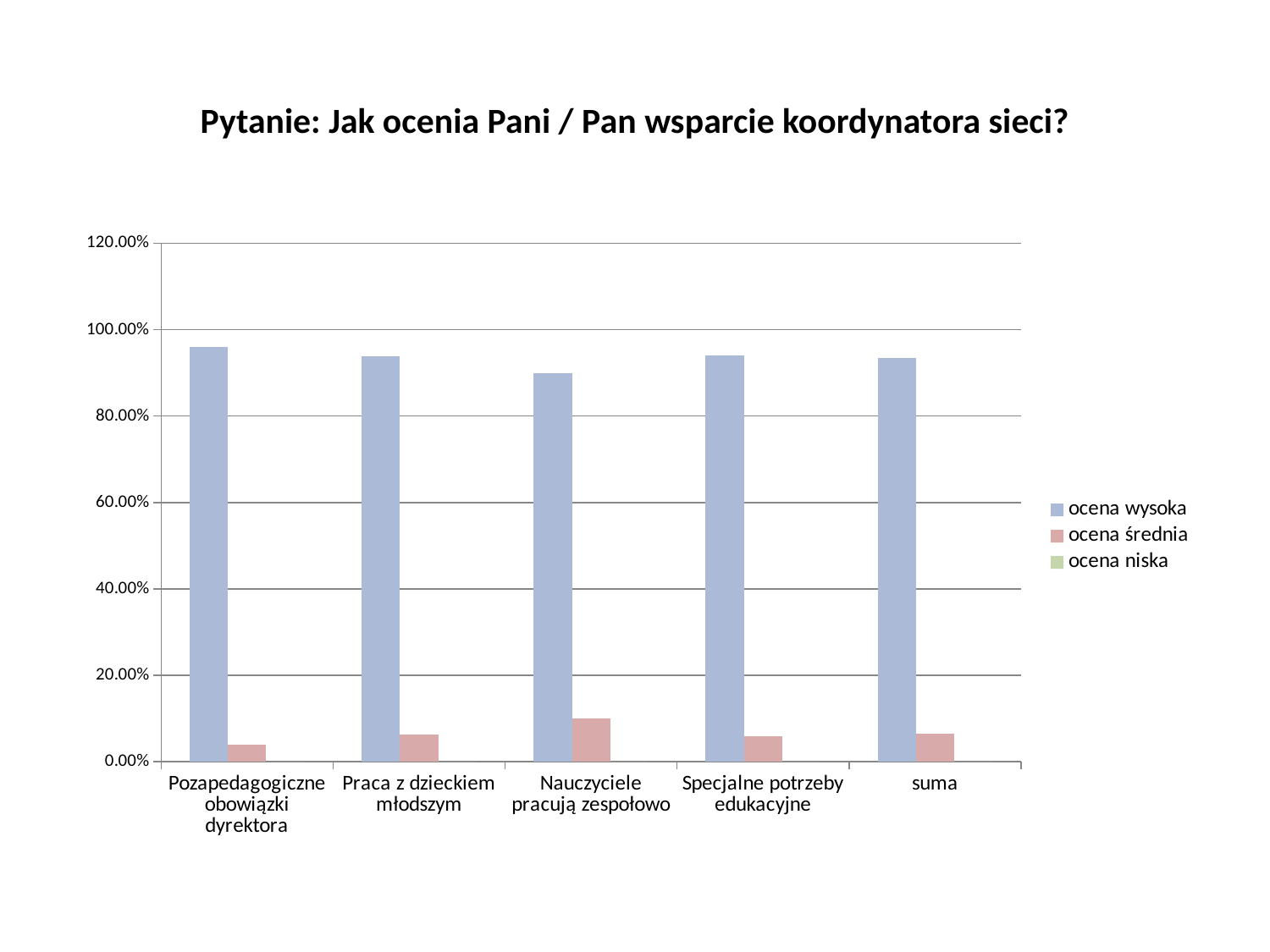
For the 'suma' category, which series has the larger value: 'ocena wysoka' or 'ocena średnia'? ocena wysoka How many categories are shown along the x axis? 5 Which category has the lowest value for the 'ocena średnia' series? Pozapedagogiczne obowiązki dyrektora Which category has the lowest value for the 'ocena wysoka' series? Nauczyciele pracują zespołowo How many series does the legend list? 3 Which category has the highest value for the 'ocena średnia' series? Nauczyciele pracują zespołowo For the 'ocena wysoka' series, which is larger: 'Pozapedagogiczne obowiązki dyrektora' or 'Nauczyciele pracują zespołowo'? Pozapedagogiczne obowiązki dyrektora Is the 'ocena wysoka' value for 'Nauczyciele pracują zespołowo' greater or less than 80.00%? greater What kind of chart is shown on the slide? bar chart Is the 'ocena wysoka' value for 'suma' greater or less than 100.00%? less What is the title of the chart? Pytanie: Jak ocenia Pani / Pan wsparcie koordynatora sieci? Is the 'ocena średnia' value for 'Nauczyciele pracują zespołowo' greater or less than 20.00%? less